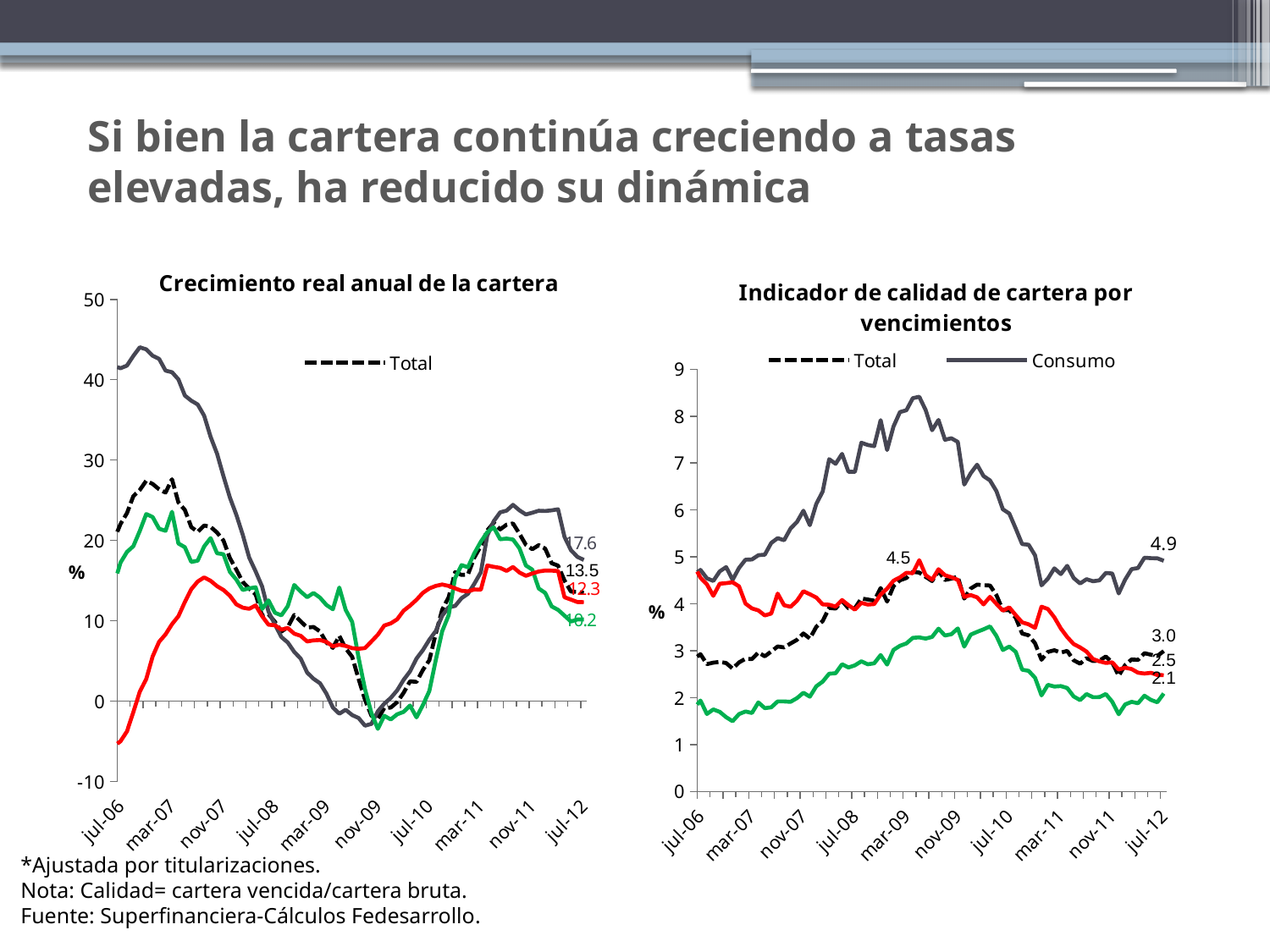
What kind of chart is the left chart, 'Crecimiento real anual de la cartera'? line chart In the right chart, 'Indicador de calidad de cartera por vencimientos', which series has the higher final value, Consumo or Total? Consumo In the right chart, 'Indicador de calidad de cartera por vencimientos', does the Consumo series rise or fall between mar-09 and jul-12? fall In the left chart, 'Crecimiento real anual de la cartera', does the Total series rise or fall between mar-07 and nov-09? fall In the right chart, 'Indicador de calidad de cartera por vencimientos', what value is labeled at the peak of the Total series around mar-09? 4.5 In the right chart, 'Indicador de calidad de cartera por vencimientos', what is the final labeled value of the Total series? 3.0 In the left chart, 'Crecimiento real anual de la cartera', what is the final labeled value of the Total series? 13.5 In the right chart, 'Indicador de calidad de cartera por vencimientos', what is the difference between the final labeled values of Consumo (4.9) and Total (3.0)? 1.9 In the right chart, 'Indicador de calidad de cartera por vencimientos', is the peak value of the Consumo series greater or less than 8? greater In the right chart, 'Indicador de calidad de cartera por vencimientos', what is the final labeled value of the Consumo series? 4.9 How many series does the legend of the right chart, 'Indicador de calidad de cartera por vencimientos', list? 2 How many series does the legend of the left chart, 'Crecimiento real anual de la cartera', list? 1